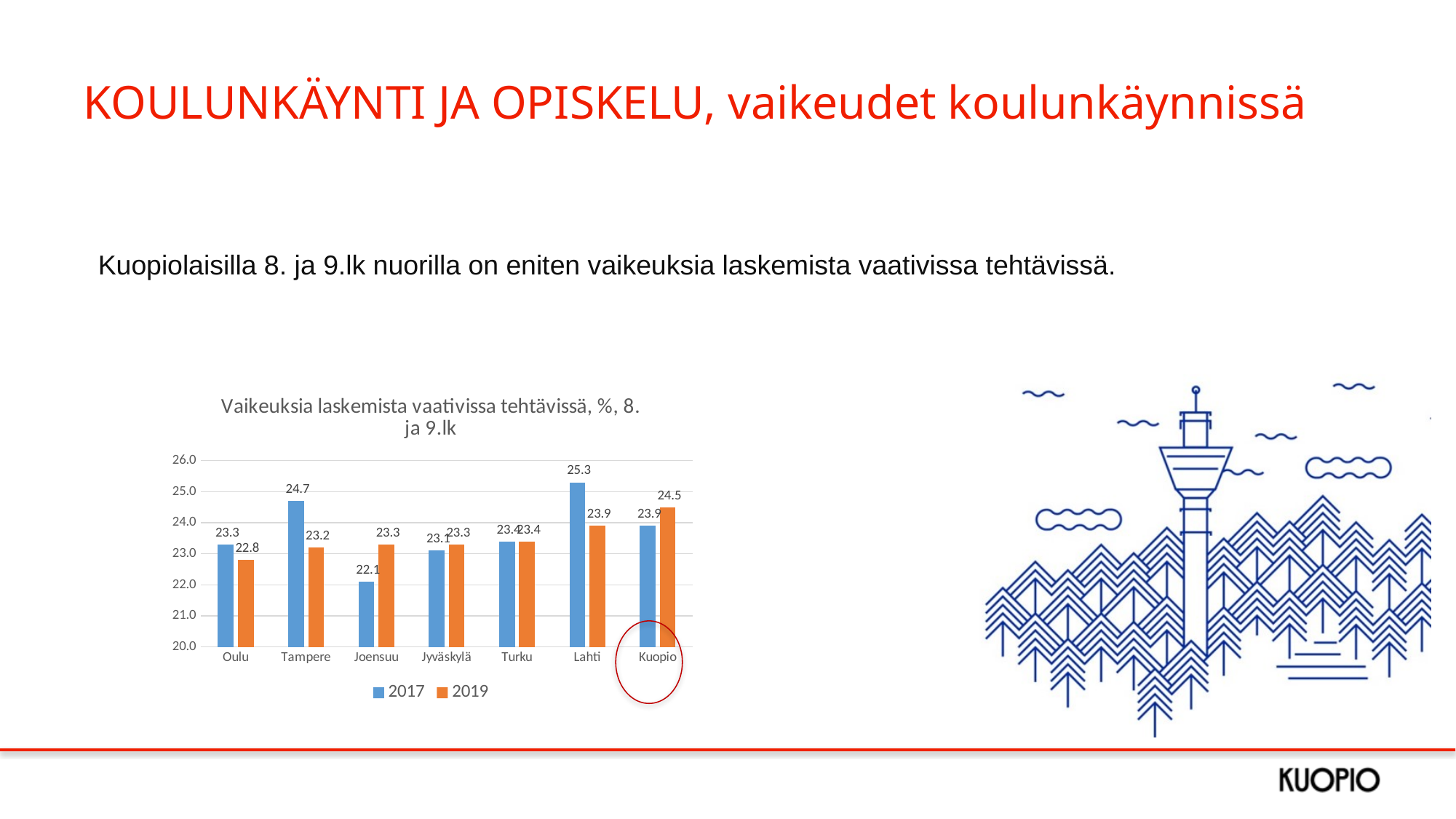
How many cities are shown on the x axis? 7 Which is larger for Lahti, the 2017 value or the 2019 value? 2017 Which city has the highest 2019 value? Kuopio Which city has the lowest 2017 value? Joensuu Which colour represents the 2019 series? Orange What is the 2019 value for Kuopio? 24.5 What kind of chart is shown? Bar chart What is the 2017 value for Lahti? 25.3 What is the difference between the 2017 and 2019 values for Tampere? 1.5 What is the 2019 value for Oulu? 22.8 What is the 2017 value for Joensuu? 22.1 How many series does the legend list? 2